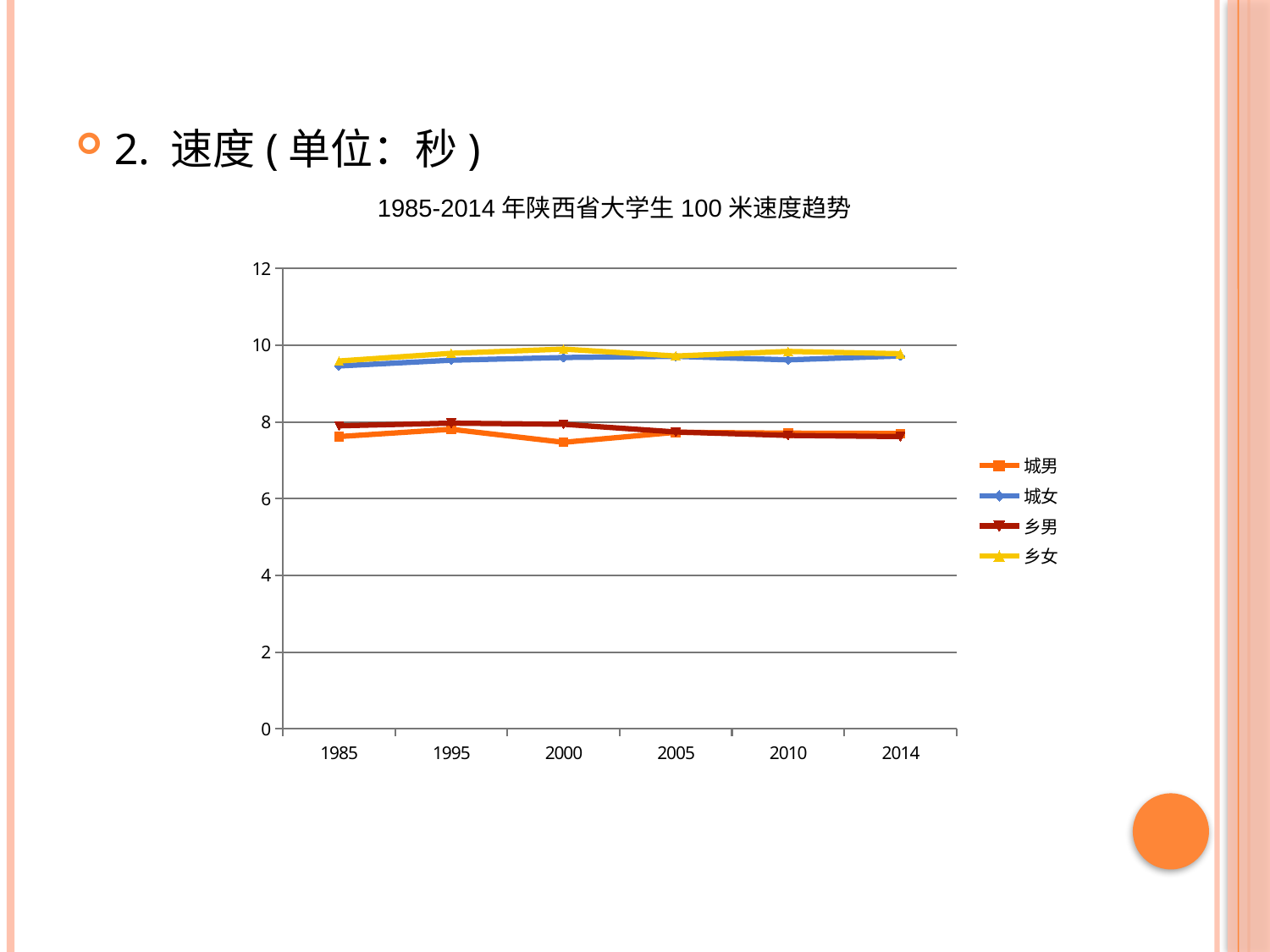
Is the value for 城男 in 1985 greater or less than 8? less In 2000, which is larger, the value for 乡男 or the value for 城男? 乡男 What kind of chart is shown on the slide? line chart Is the value for 城女 in 2010 greater or less than 10? less How many series does the legend list? 4 Is the value for 乡男 in 2014 greater or less than 8? less In 2000, which is larger, the value for 城女 or the value for 城男? 城女 What is the title of the chart? 1985-2014年陕西省大学生100米速度趋势 Which series is shown in yellow in the legend? 乡女 How many years are plotted along the x axis? 6 Does the value for 乡男 rise or fall from 1995 to 2014? fall